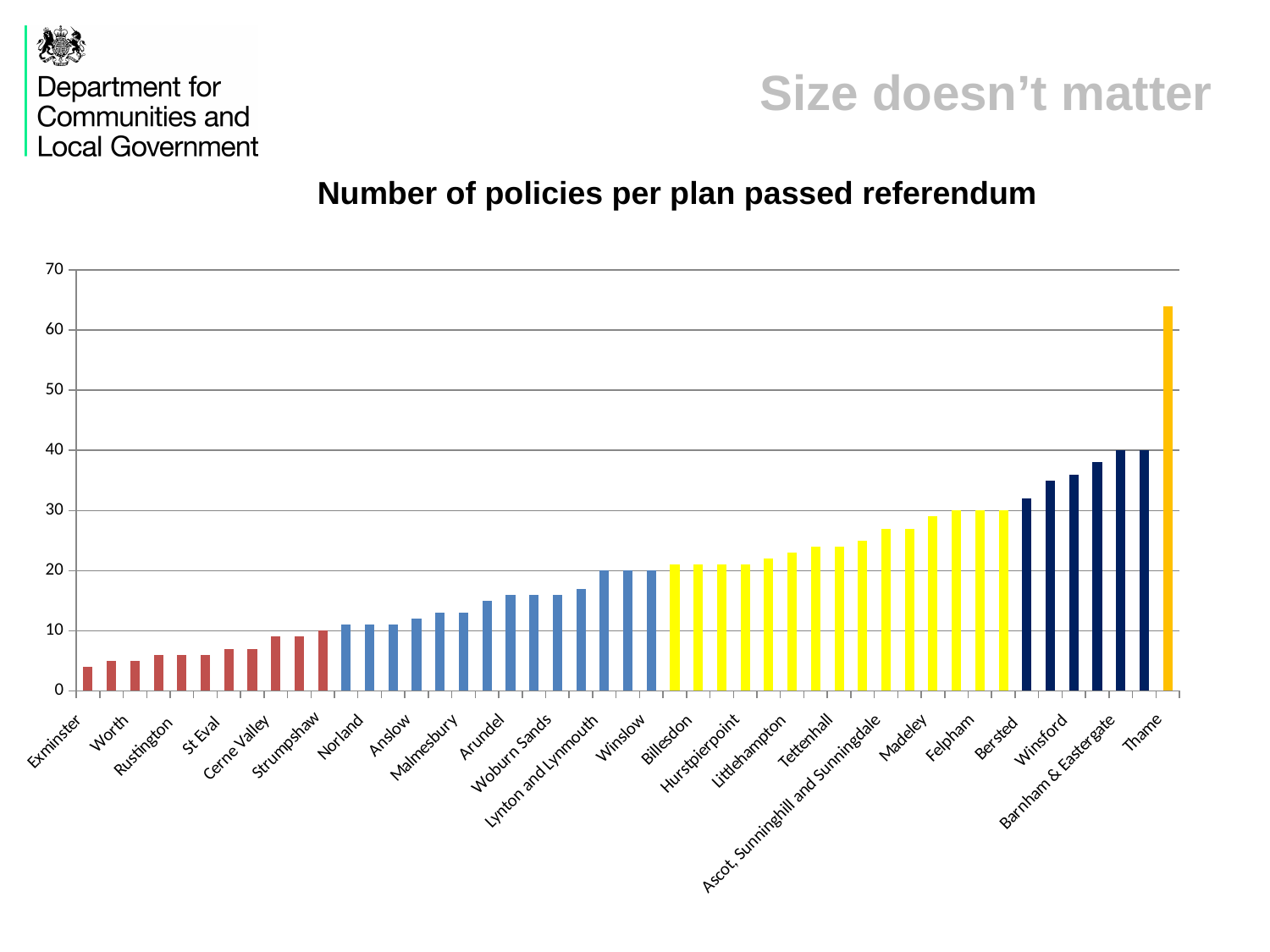
Which category has the lowest value? Exminster Is the value for Madeley greater or less than 20? greater Is the value for Thame greater or less than 60? greater What is the value for Winslow? 20 Is the value for Exminster greater or less than 10? less What type of chart is shown on the slide? bar chart What is the title of the chart? Number of policies per plan passed referendum Which has a larger value, Thame or Winsford? Thame What is the value for Strumpshaw? 10 What is the value for Barnham & Eastergate? 40 Which category has the highest value? Thame Do the values rise or fall from left to right along the x axis? rise